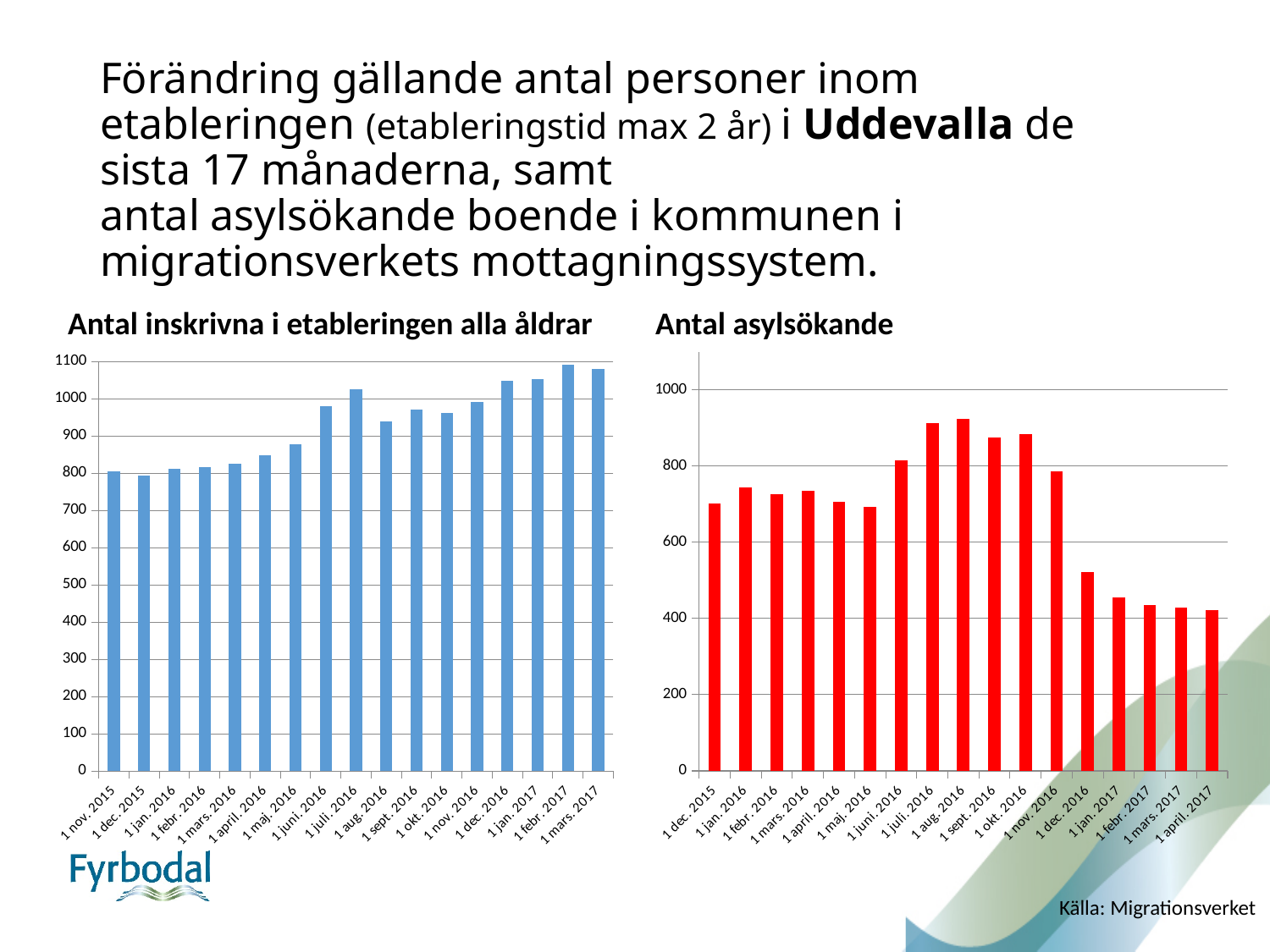
In the 'Antal inskrivna i etableringen alla åldrar' chart, which is larger: the value for 1 juli 2016 or 1 aug. 2016? 1 juli 2016 In the 'Antal asylsökande' chart, do the values rise or fall from 1 nov. 2016 to 1 april 2017? fall In the 'Antal asylsökande' chart, is the value for 1 juli 2016 greater or less than 800? greater What kind of chart is the 'Antal inskrivna i etableringen alla åldrar' chart? bar chart How many bars (months) are plotted in the 'Antal asylsökande' chart? 17 In the 'Antal inskrivna i etableringen alla åldrar' chart, is the value for 1 maj 2016 greater or less than 900? less How many bars (months) are plotted in the 'Antal inskrivna i etableringen alla åldrar' chart? 17 In the 'Antal asylsökande' chart, is the value for 1 maj 2016 greater or less than 800? less What colour are the bars in the 'Antal asylsökande' chart? red In the 'Antal asylsökande' chart, which is larger: the value for 1 nov. 2016 or 1 dec. 2016? 1 nov. 2016